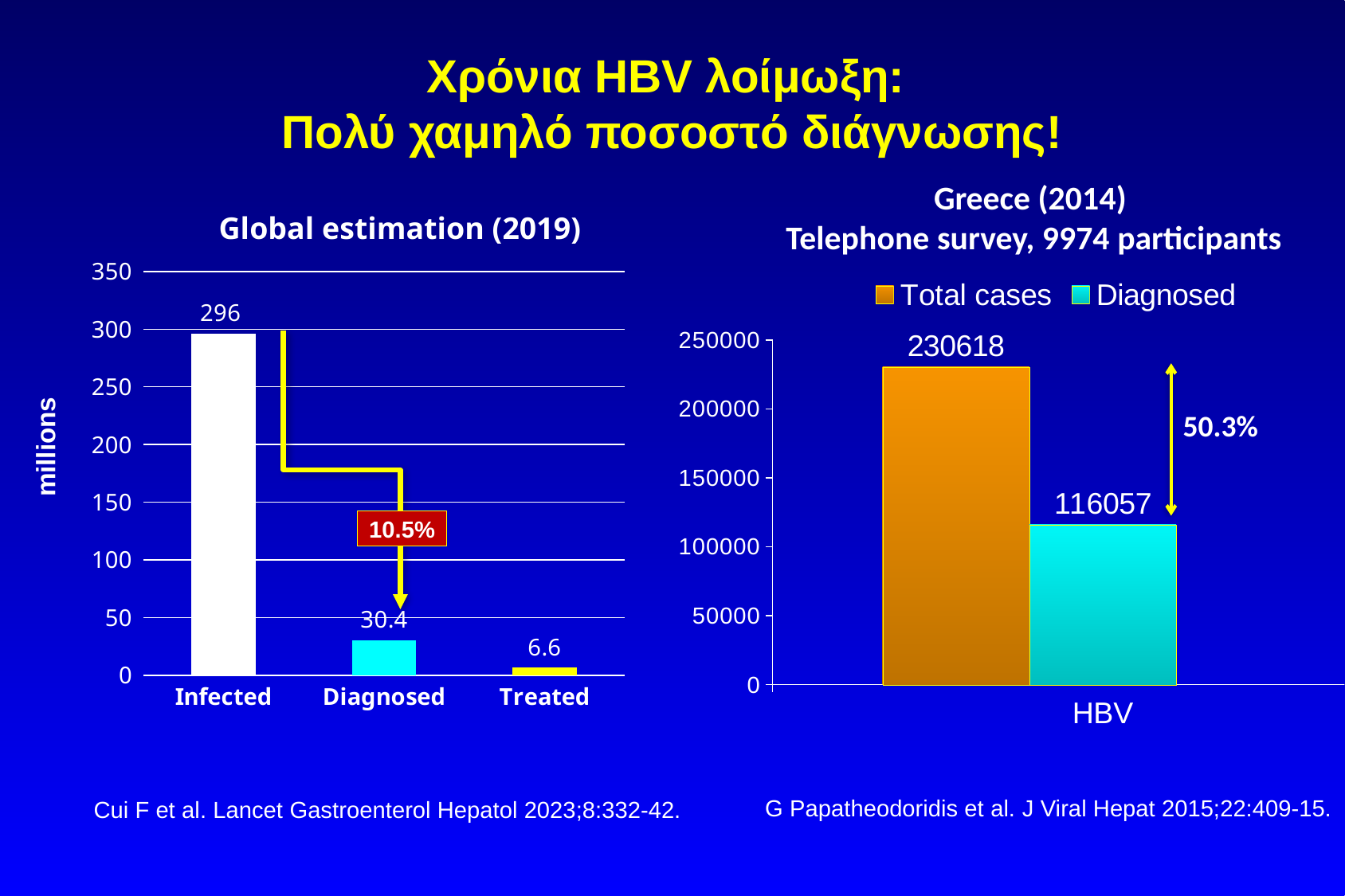
In the 'Greece (2014)' chart, what is the value for Diagnosed? 116057 In the 'Global estimation (2019)' chart, what is the difference between Infected and Diagnosed? 265.6 In the 'Global estimation (2019)' chart, what is the value for Treated? 6.6 In the 'Global estimation (2019)' chart, what is the value for Infected? 296 In the 'Global estimation (2019)' chart, which category has the lowest value? Treated In the 'Greece (2014)' chart, how many series does the legend list? 2 In the 'Greece (2014)' chart, what is the difference between Total cases and Diagnosed? 114561 In the 'Global estimation (2019)' chart, how many categories are shown on the x axis? 3 In the 'Global estimation (2019)' chart, what is the value for Diagnosed? 30.4 What kind of chart is the 'Greece (2014)' chart? bar chart In the 'Global estimation (2019)' chart, what is the y-axis label? millions In the 'Greece (2014)' chart, what is the value for Total cases? 230618